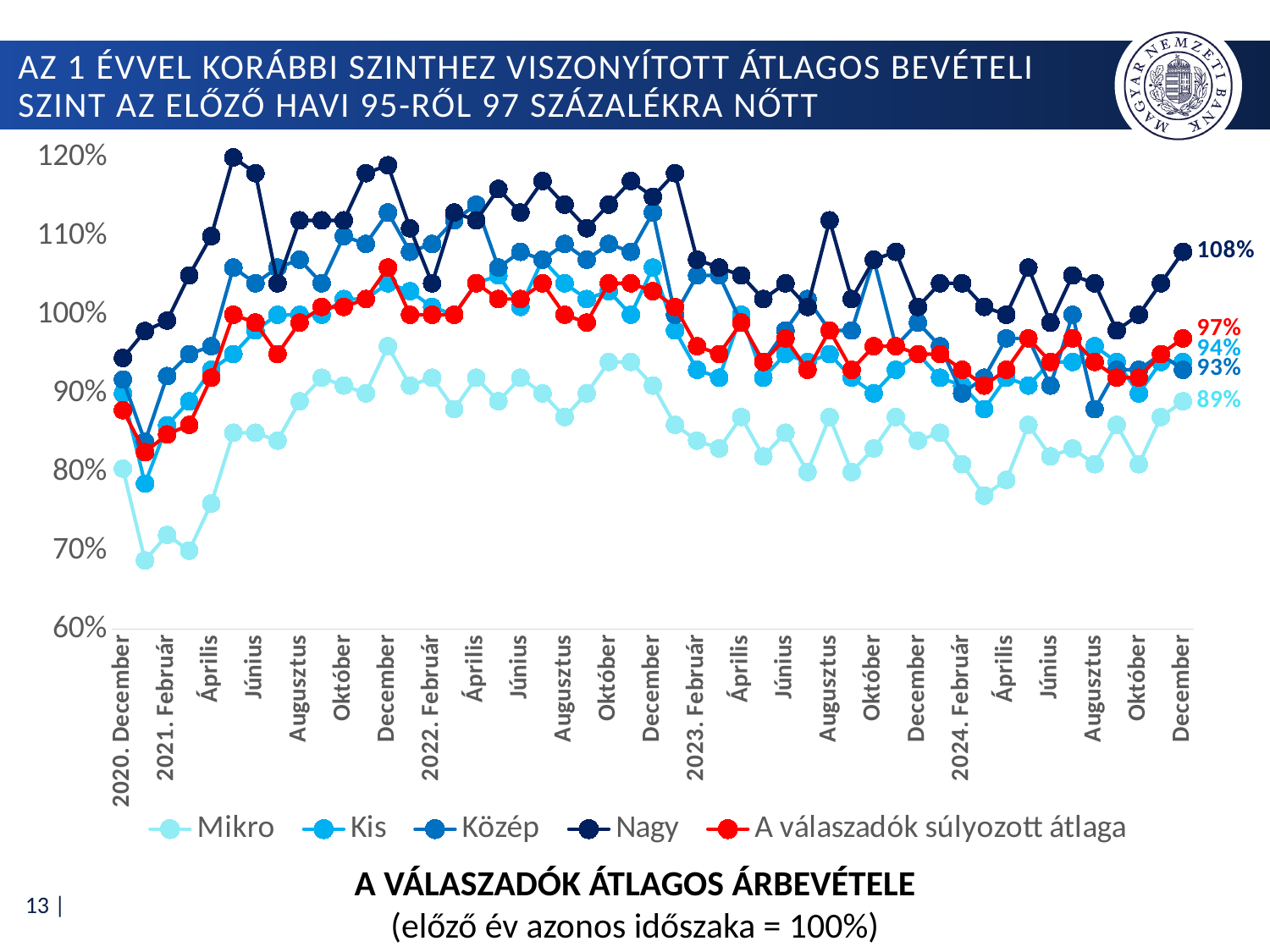
What is the value of the Nagy series at the last point (2024 December)? 108% What is the value of the Mikro series at the last point (2024 December)? 89% Which series has the highest value at the last point (2024 December)? Nagy Is the value of the Mikro series in 2021 January greater or less than 70%? less How many series does the legend list? 5 Is the value of the Nagy series in 2021 December greater or less than 110%? greater What is the difference between the Nagy and Mikro values at the last point (2024 December)? 19 percentage points What is the value of the Kis series at the last point (2024 December)? 94% What kind of chart is shown on the slide? Line chart What is the value of 'A válaszadók súlyozott átlaga' at the last point (2024 December)? 97% Which series has the lowest value at the last point (2024 December)? Mikro At the last point (2024 December), which is larger: the Kis value or the Közép value? Kis